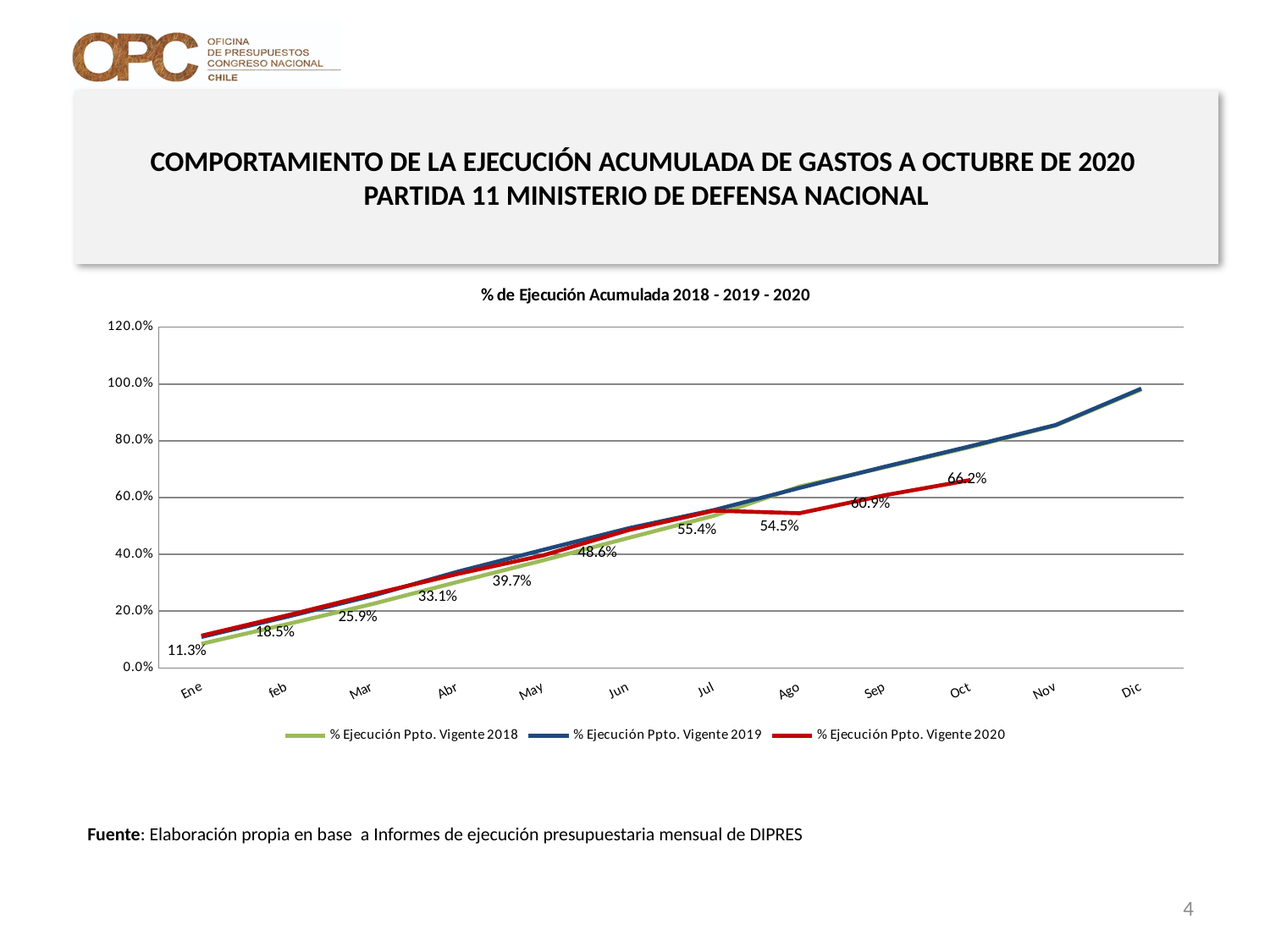
How many series does the legend list? 3 What kind of chart is shown on the slide? Line chart What is the difference between the 2020 values for Oct and Sep? 5.3 percentage points How many months are shown on the x axis? 12 What is the value of % Ejecución Ppto. Vigente 2020 in Ene? 11.3% Which is larger for the 2020 series: the value in Jul or the value in Ago? Jul What is the value of % Ejecución Ppto. Vigente 2020 in Oct? 66.2% What is the value of % Ejecución Ppto. Vigente 2020 in Ago? 54.5% Is the value of % Ejecución Ppto. Vigente 2019 in Dic greater or less than 80.0%? greater In which month does the 2020 series reach its highest labelled value? Oct Does the % Ejecución Ppto. Vigente 2019 series rise or fall from Ene to Dic? Rise What is the title of the chart? % de Ejecución Acumulada 2018 - 2019 - 2020